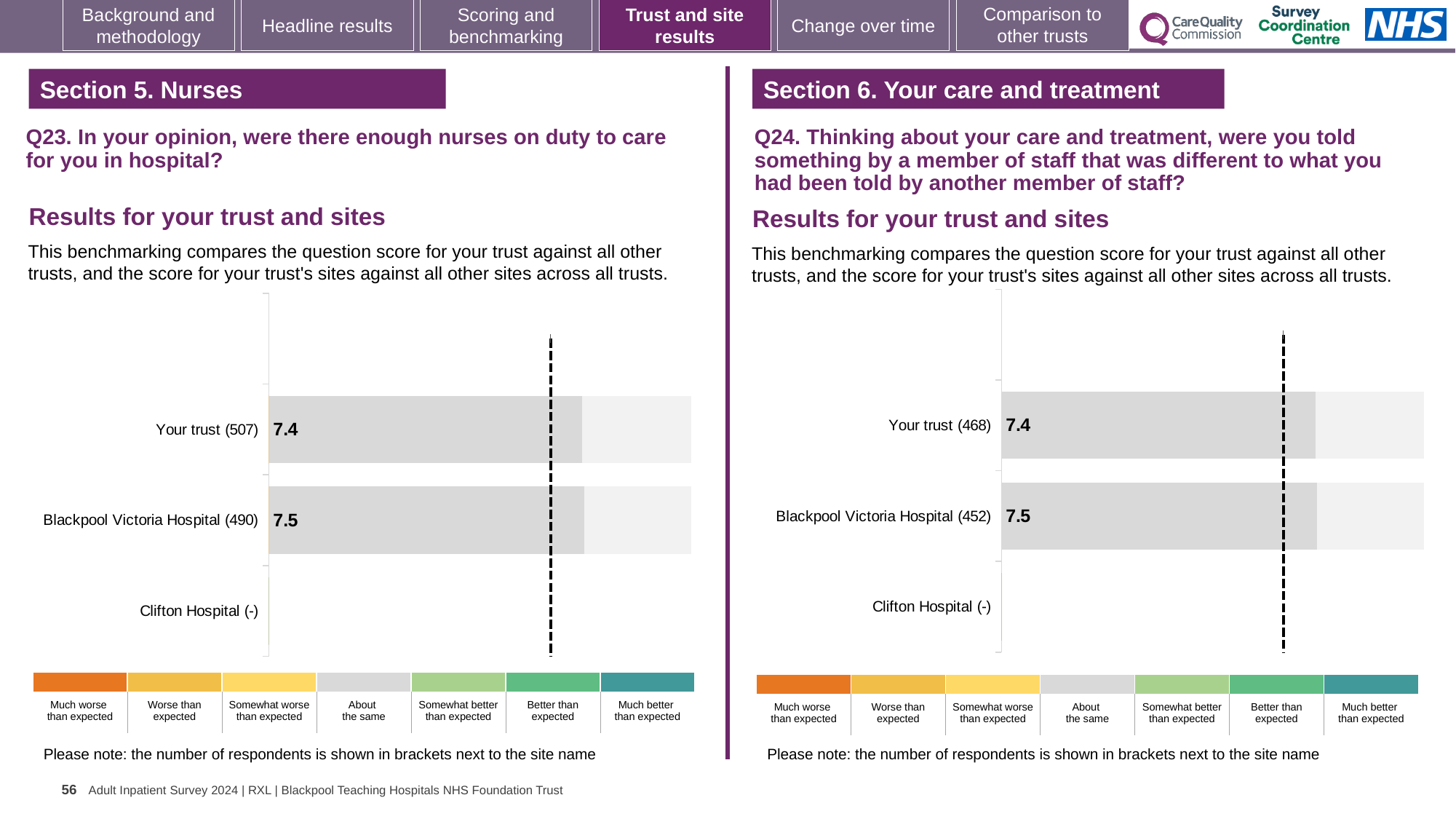
On the Q24 chart (right), what is the score for Blackpool Victoria Hospital (452)? 7.5 On the Q23 chart (left), how many respondents are shown in brackets for Blackpool Victoria Hospital? 490 On the Q24 chart (right), how many respondents are shown in brackets for Your trust? 468 On the Q23 chart (left), what is the score for Blackpool Victoria Hospital (490)? 7.5 On the Q24 chart (right), what is the score for Your trust (468)? 7.4 On the Q24 chart (right), which has the lower score, Your trust or Blackpool Victoria Hospital? Your trust On the Q23 chart (left), how many site/trust categories are listed on the vertical axis? 3 On the Q24 chart (right), what is the difference between the Blackpool Victoria Hospital score and the Your trust score? 0.1 What type of chart is used on the Q24 chart (right)? Bar chart On the Q23 chart (left), what is the score for Your trust (507)? 7.4 On the Q23 chart (left), what is shown for Clifton Hospital? (-) On the Q23 chart (left), which has the higher score, Your trust or Blackpool Victoria Hospital? Blackpool Victoria Hospital